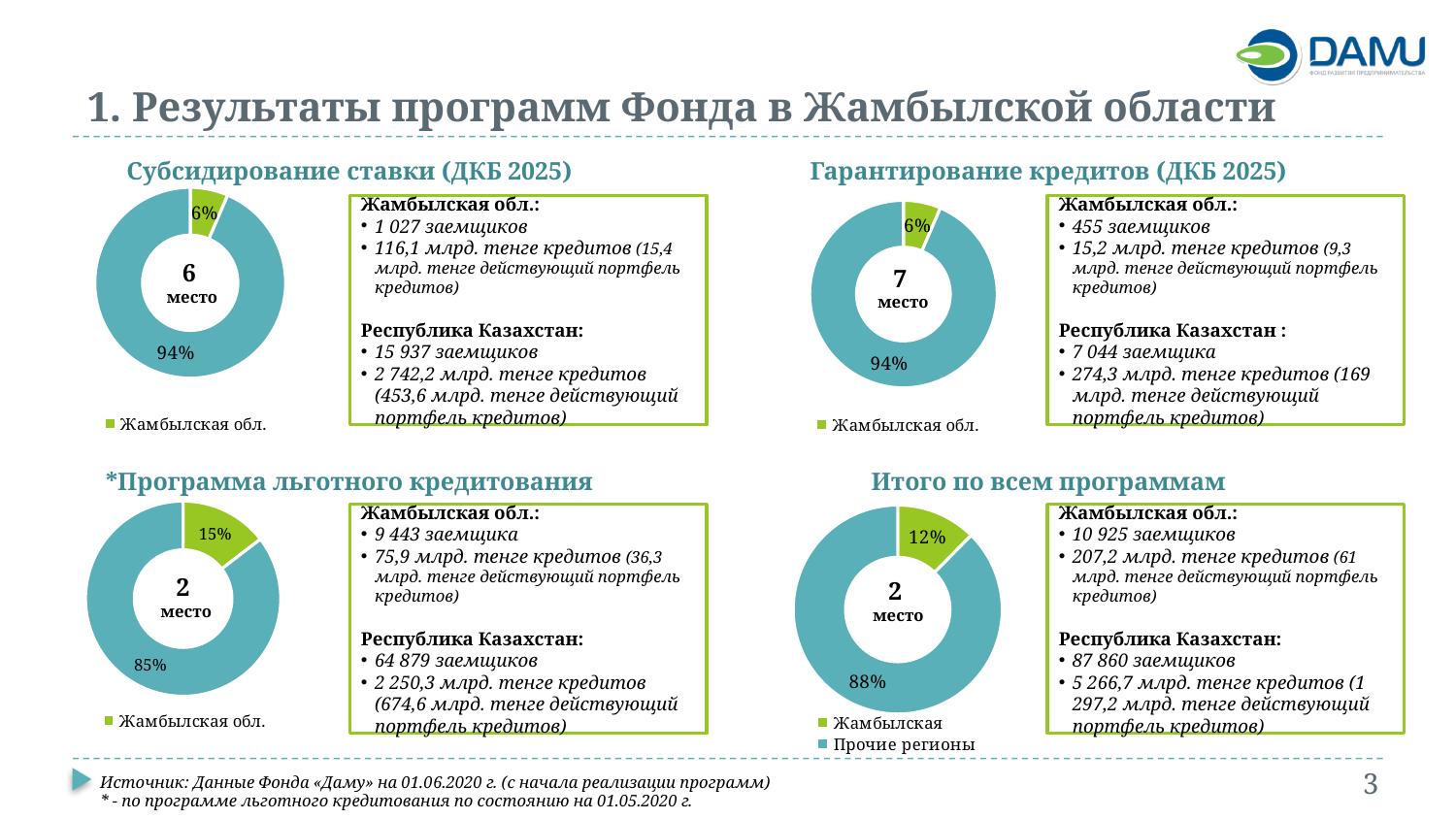
What text is written in the centre of the 'Гарантирование кредитов (ДКБ 2025)' chart? 7 место Across the four charts, which one shows the highest share for Жамбылская обл.? *Программа льготного кредитования In the '*Программа льготного кредитования' chart, what is the difference between the 85% slice and the 15% slice? 70% In the 'Субсидирование ставки (ДКБ 2025)' chart, what share is labelled for Жамбылская обл.? 6% What is the legend entry shown under the 'Субсидирование ставки (ДКБ 2025)' chart? Жамбылская обл. How many charts are shown on the slide? 4 Which chart shows a larger share for Жамбылская обл.: '*Программа льготного кредитования' or 'Итого по всем программам'? *Программа льготного кредитования In the 'Итого по всем программам' chart, what percentage is shown for Прочие регионы? 88% In the 'Гарантирование кредитов (ДКБ 2025)' chart, what percentage is shown on the large teal slice? 94% How many entries does the legend of the 'Итого по всем программам' chart list? 2 In the '*Программа льготного кредитования' chart, what share is labelled for Жамбылская обл.? 15% What kind of chart is used in the 'Итого по всем программам' section? doughnut chart